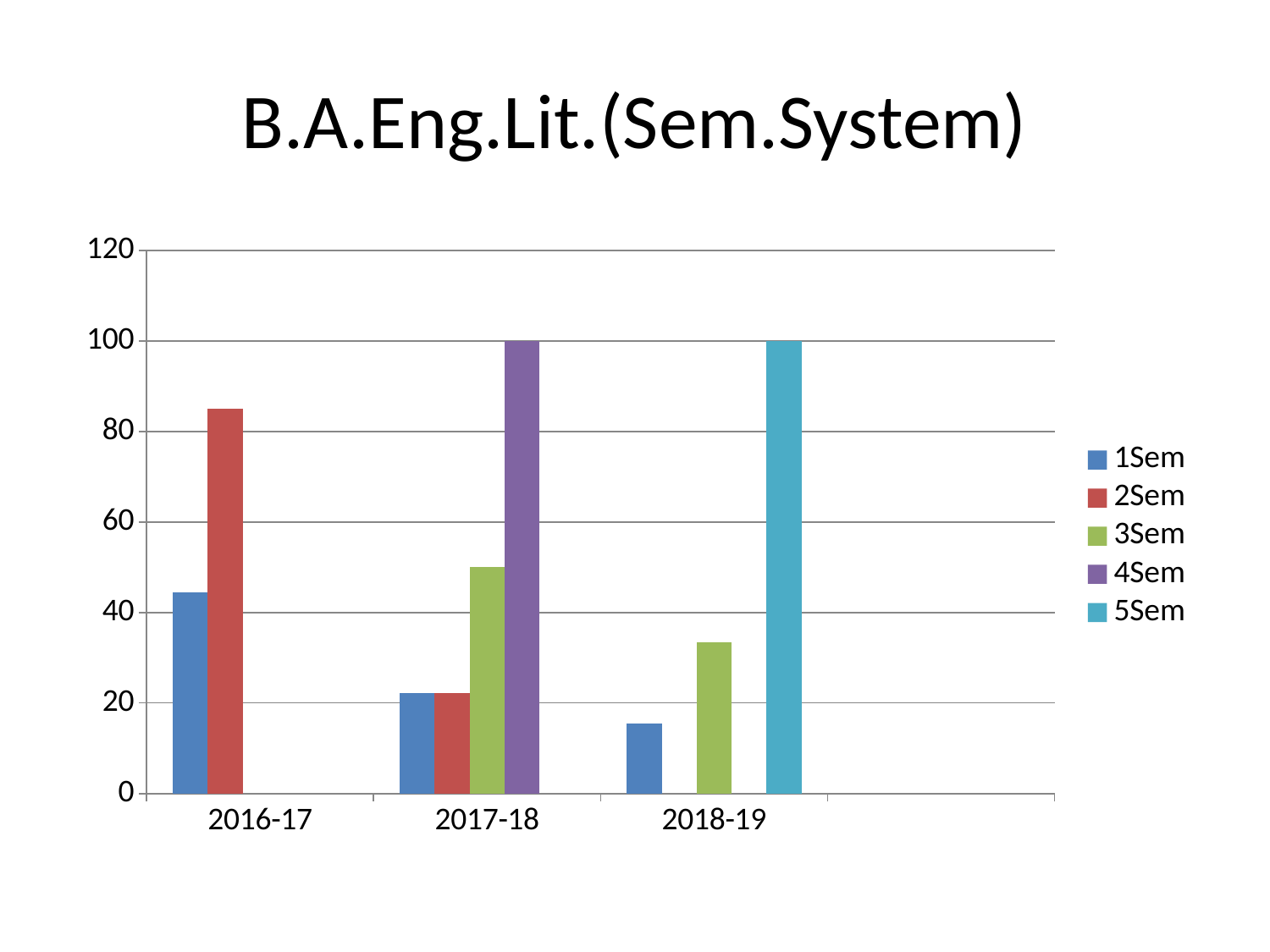
What kind of chart is shown on the slide? bar chart Which series has the lowest value in 2018-19? 1Sem Which is larger in 2017-18, the value for 3Sem or the value for 1Sem? 3Sem Which series has the highest value in 2016-17? 2Sem Is the value for 3Sem in 2018-19 greater or less than 40? less What is the value for 4Sem in 2017-18? 100 Is the value for 2Sem in 2016-17 greater or less than 80? greater Is the value for 1Sem in 2018-19 greater or less than 20? less How many series does the legend list? 5 What is the title of the chart? B.A.Eng.Lit.(Sem.System) How many year categories are shown on the x axis? 3 What is the value for 5Sem in 2018-19? 100